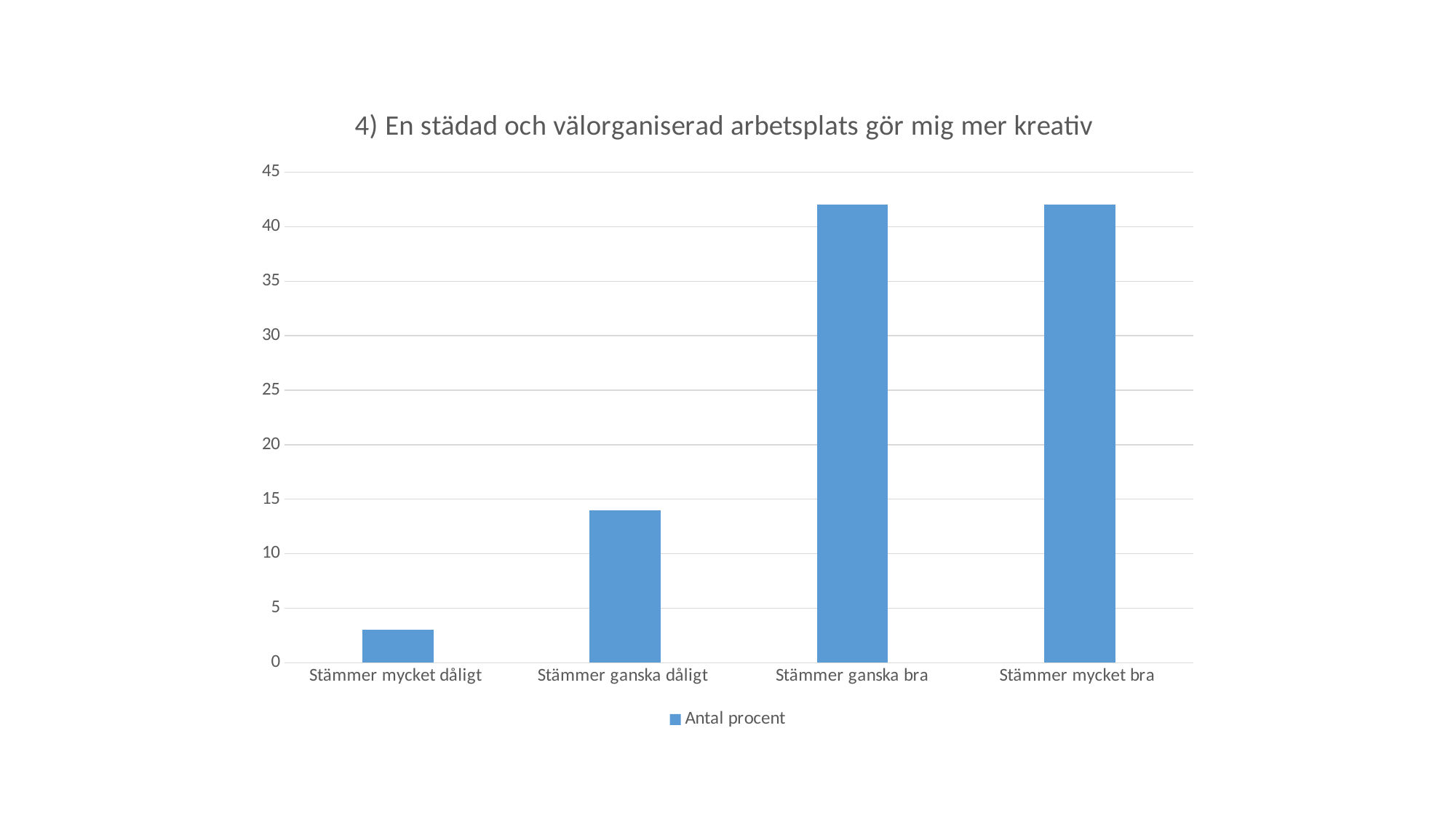
Which category has the lowest value? Stämmer mycket dåligt Is the value for Stämmer ganska dåligt greater or less than 10? greater How many series does the legend list? 1 Which is larger, the value for Stämmer ganska dåligt or the value for Stämmer mycket dåligt? Stämmer ganska dåligt What kind of chart is shown on the slide? bar chart How many categories are shown on the x axis of the chart? 4 Is the value for Stämmer ganska dåligt greater or less than 15? less Is the value for Stämmer ganska bra greater or less than 40? greater Which is larger, the value for Stämmer ganska bra or the value for Stämmer ganska dåligt? Stämmer ganska bra What is the name of the series shown in the legend? Antal procent